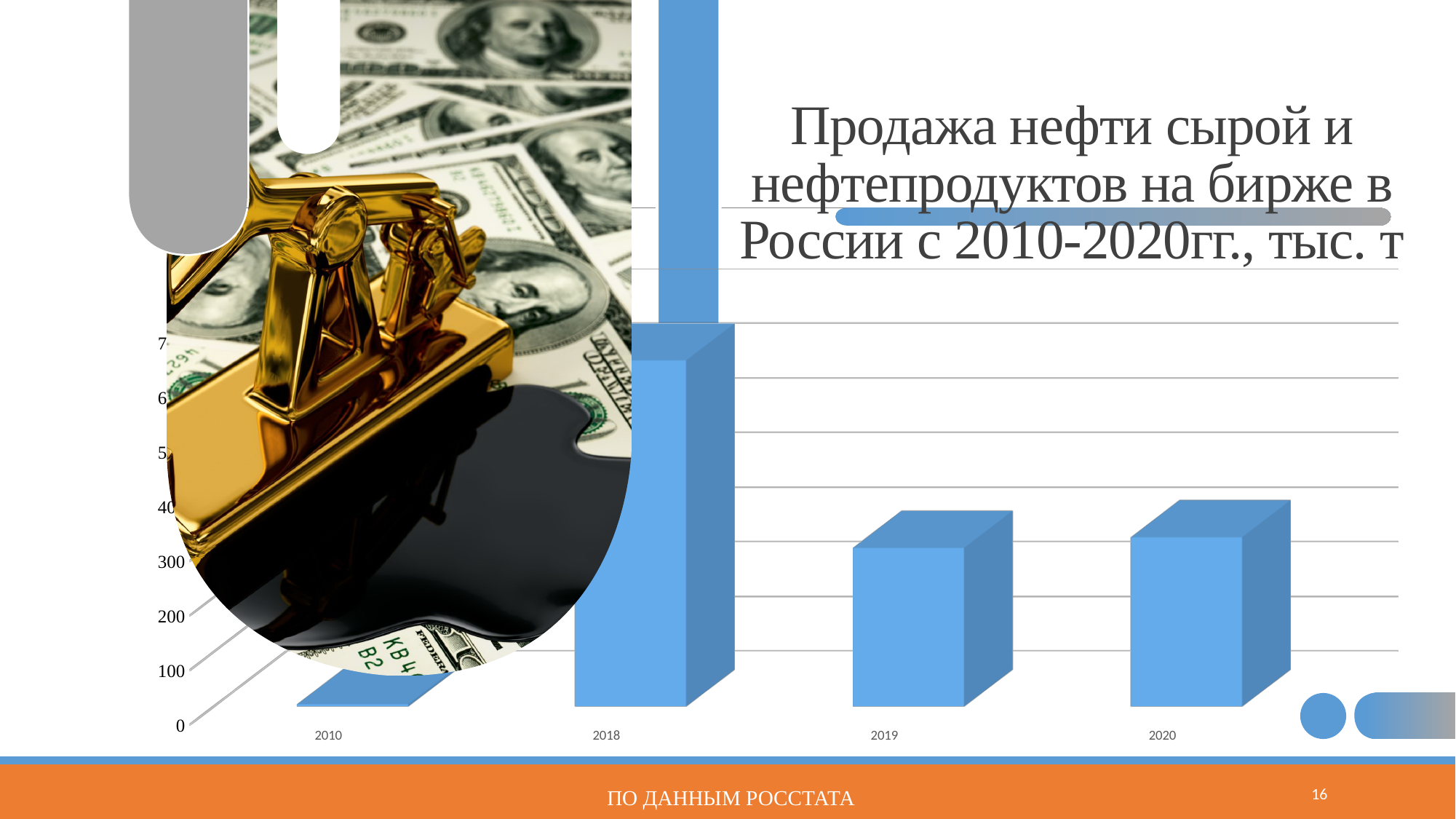
Is the value for 2019 greater or less than 200? greater Do the values fall or rise from 2018 to 2019? fall Is the value for 2019 greater or less than 400? less Is the value for 2020 greater or less than 200? greater How many year categories are labelled on the x axis of the chart? 4 What is the title of the chart on the slide? Продажа нефти сырой и нефтепродуктов на бирже в России с 2010-2020гг., тыс. т What kind of chart is shown on the slide? bar chart Which is larger, the value for 2018 or the value for 2020? 2018 Which is larger, the value for 2018 or the value for 2019? 2018